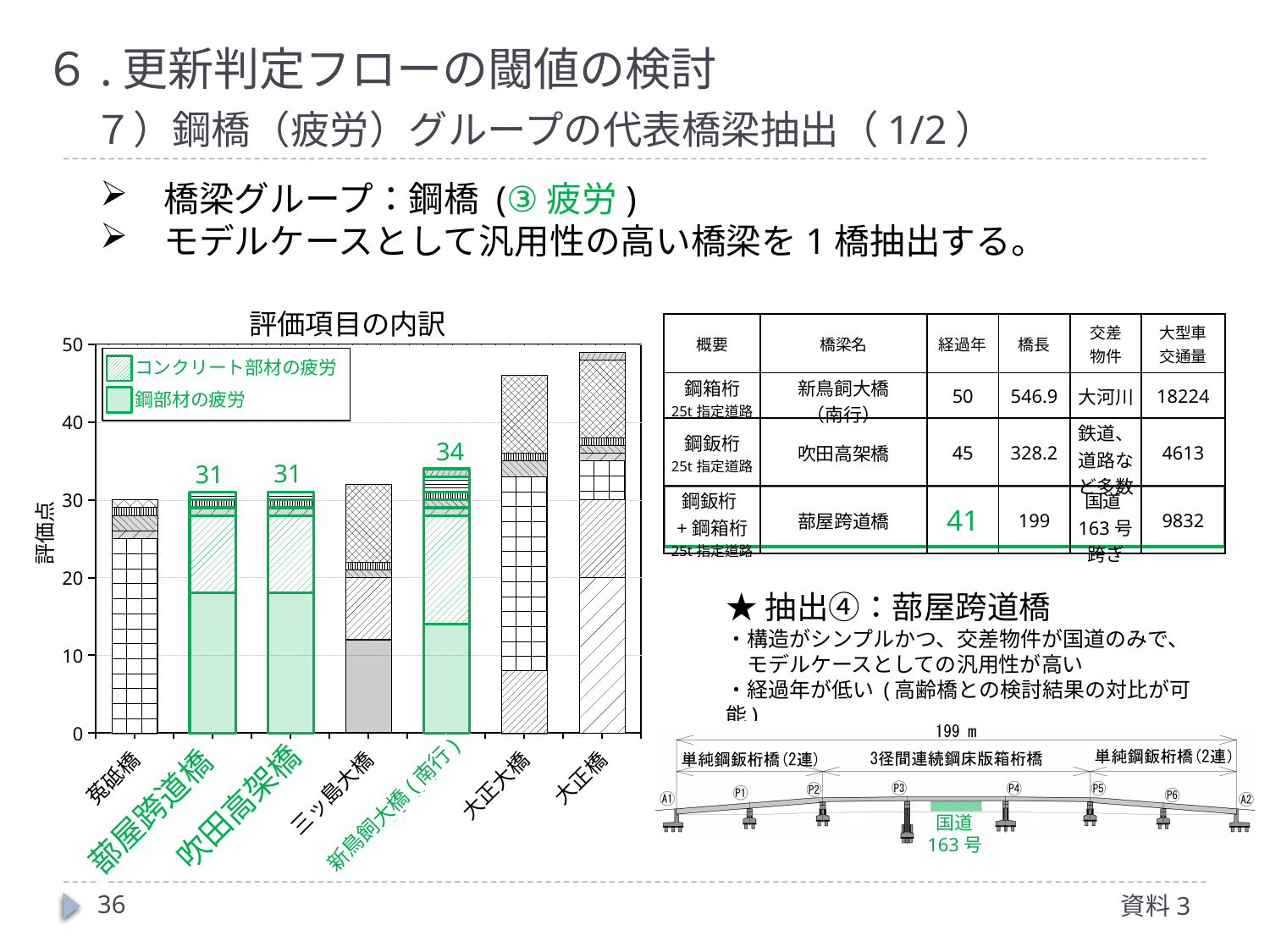
Which bridge has the highest bar in the 評価項目の内訳 chart? 大正橋 How many bridges are shown on the x axis of the 評価項目の内訳 chart? 7 What is the total value shown for 吹田高架橋 in the 評価項目の内訳 chart? 31 Is the total bar height for 菟砥橋 greater or less than 40? less What is the total value shown for 蔀屋跨道橋 in the 評価項目の内訳 chart? 31 What kind of chart is 評価項目の内訳? Stacked bar chart Is the total bar height for 大正大橋 greater or less than 40? greater Which has the larger labelled total, 新鳥飼大橋(南行) or 吹田高架橋? 新鳥飼大橋(南行) What is the difference between the labelled totals for 新鳥飼大橋(南行) and 蔀屋跨道橋? 3 Which bar is taller in the 評価項目の内訳 chart, 大正橋 or 菟砥橋? 大正橋 What is the total value shown for 新鳥飼大橋(南行) in the 評価項目の内訳 chart? 34 How many entries does the legend of the 評価項目の内訳 chart list? 2